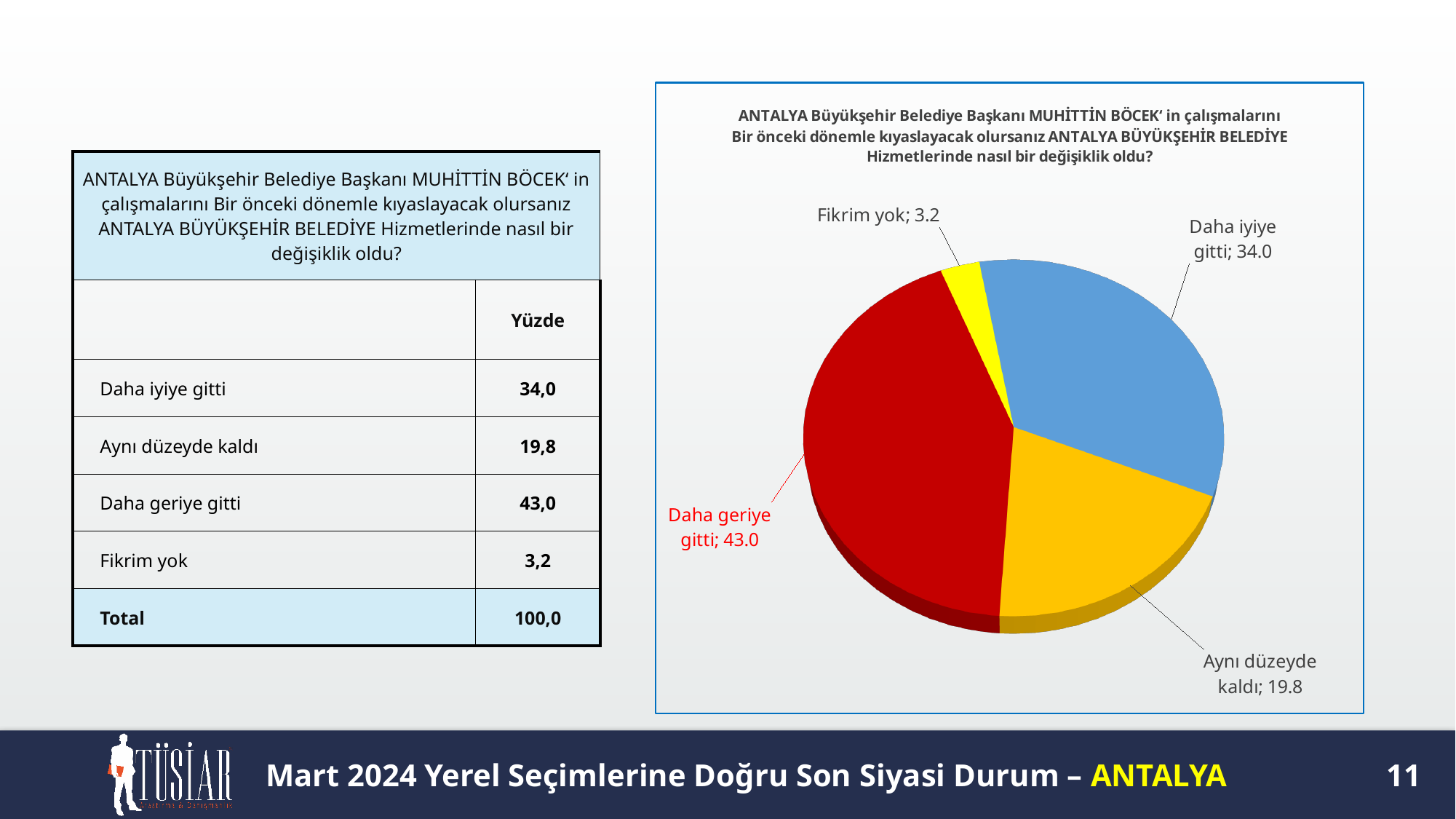
What is the difference between the values for "Aynı düzeyde kaldı" and "Fikrim yok"? 16.6 What is the difference between the values for "Daha geriye gitti" and "Daha iyiye gitti"? 9.0 What is the value for "Daha geriye gitti" in the pie chart? 43.0 What is the value for "Aynı düzeyde kaldı" in the pie chart? 19.8 What is the value for "Fikrim yok" in the pie chart? 3.2 What type of chart is shown on the slide? pie chart How many slices does the pie chart have? 4 Which category has the largest slice in the pie chart? Daha geriye gitti Which is larger: "Daha iyiye gitti" or "Aynı düzeyde kaldı"? Daha iyiye gitti Which category has the smallest slice in the pie chart? Fikrim yok What is the value for "Daha iyiye gitti" in the pie chart? 34.0 What colour is the "Daha geriye gitti" slice in the pie chart? red